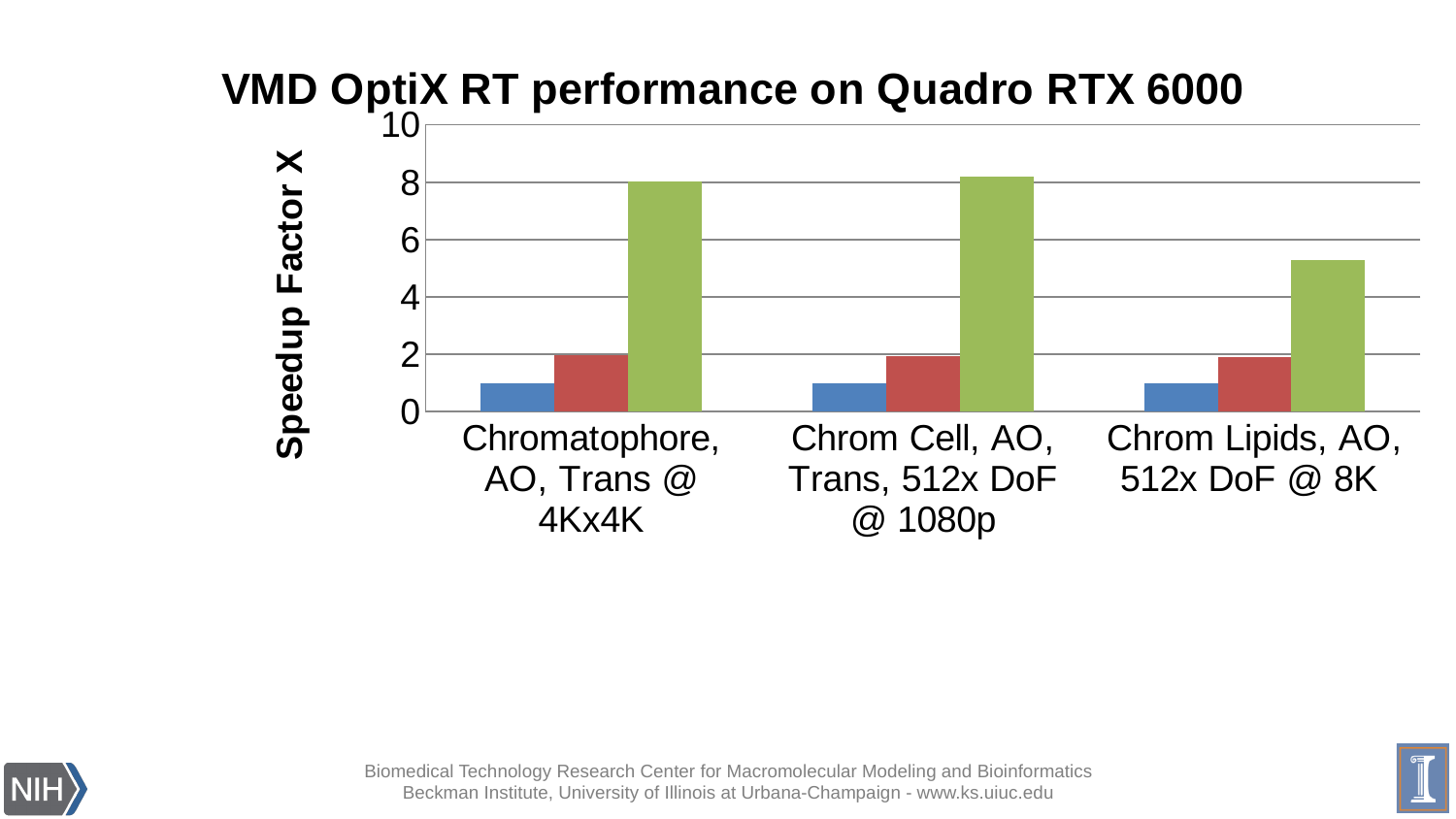
Is the value of the blue bar for "Chromatophore, AO, Trans @ 4Kx4K" greater or less than 2? less Is the value of the green bar for "Chrom Lipids, AO, 512x DoF @ 8K" greater or less than 6? less What is the maximum value shown on the vertical axis of the chart? 10 Is the value of the green bar for "Chrom Cell, AO, Trans, 512x DoF @ 1080p" greater or less than 6? greater How many bars are plotted for each category in the chart? 3 Among the three categories, which has the lowest green bar? Chrom Lipids, AO, 512x DoF @ 8K What is the title of the chart? VMD OptiX RT performance on Quadro RTX 6000 For "Chrom Cell, AO, Trans, 512x DoF @ 1080p", which bar is taller, the green bar or the red bar? green bar What kind of chart is shown on the slide? bar chart How many categories are shown along the x axis of the chart? 3 What is the label on the vertical axis of the chart? Speedup Factor X